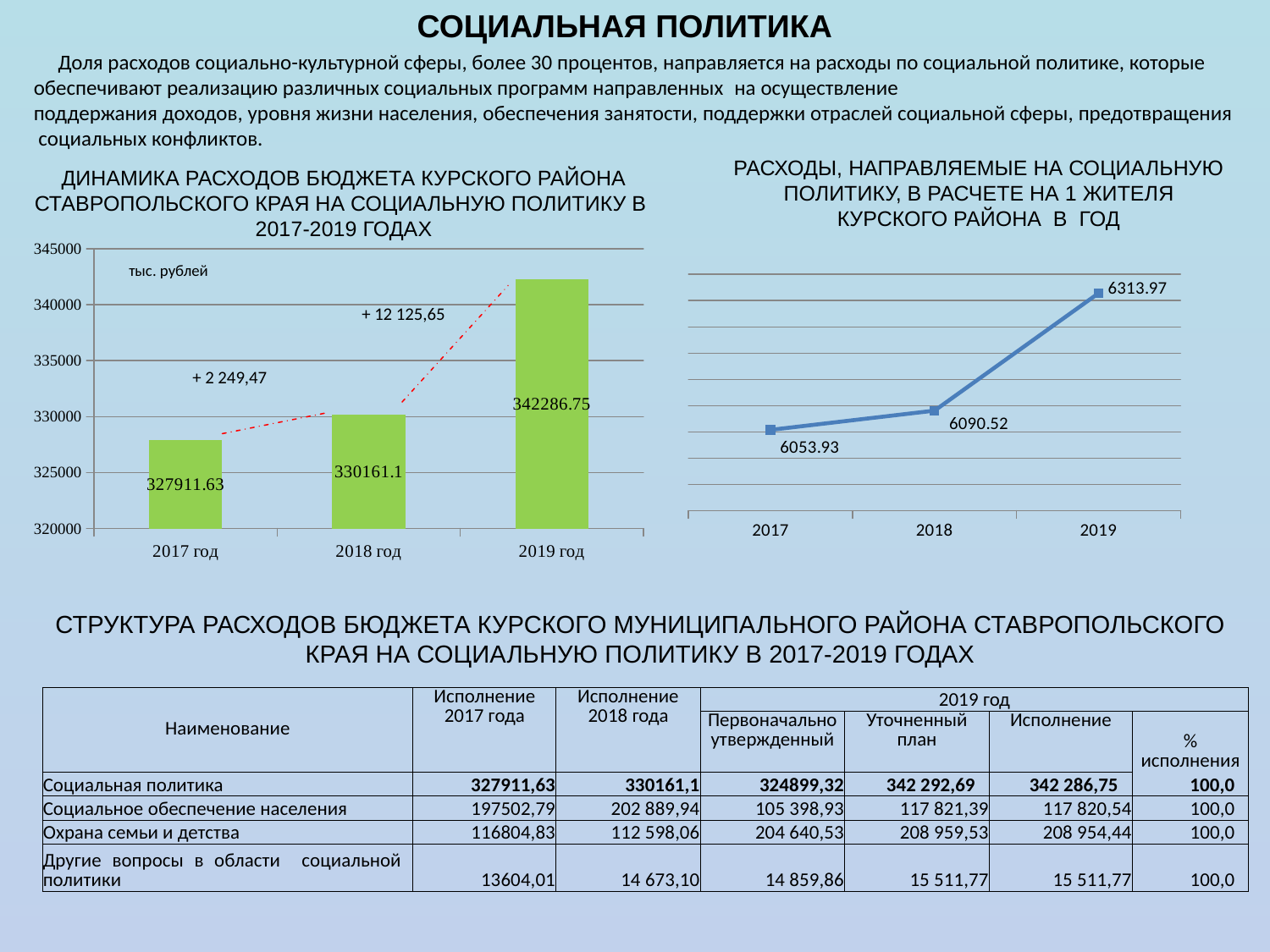
In the line chart on the right (РАСХОДЫ, НАПРАВЛЯЕМЫЕ НА СОЦИАЛЬНУЮ ПОЛИТИКУ, В РАСЧЕТЕ НА 1 ЖИТЕЛЯ), what is the value for 2018? 6090.52 In the bar chart on the left, what is the difference between the 2019 год and 2018 год values? 12125.65 How many data points are plotted in the line chart on the right? 3 In the line chart on the right, what is the difference between the 2019 and 2018 values? 223.45 In the bar chart on the left, which year has the lowest value? 2017 год In the line chart on the right, which year has the highest value? 2019 In the bar chart on the left, what is the value for 2019 год? 342286.75 In the bar chart on the left, what unit is indicated inside the plot area? тыс. рублей In the bar chart on the left (ДИНАМИКА РАСХОДОВ БЮДЖЕТА...), what is the value for 2017 год? 327911.63 In the line chart on the right, do the values rise or fall from 2017 to 2019? rise What kind of chart is the chart on the left of the slide? bar chart In the bar chart on the left, is the value for 2019 год greater or less than 340000? greater